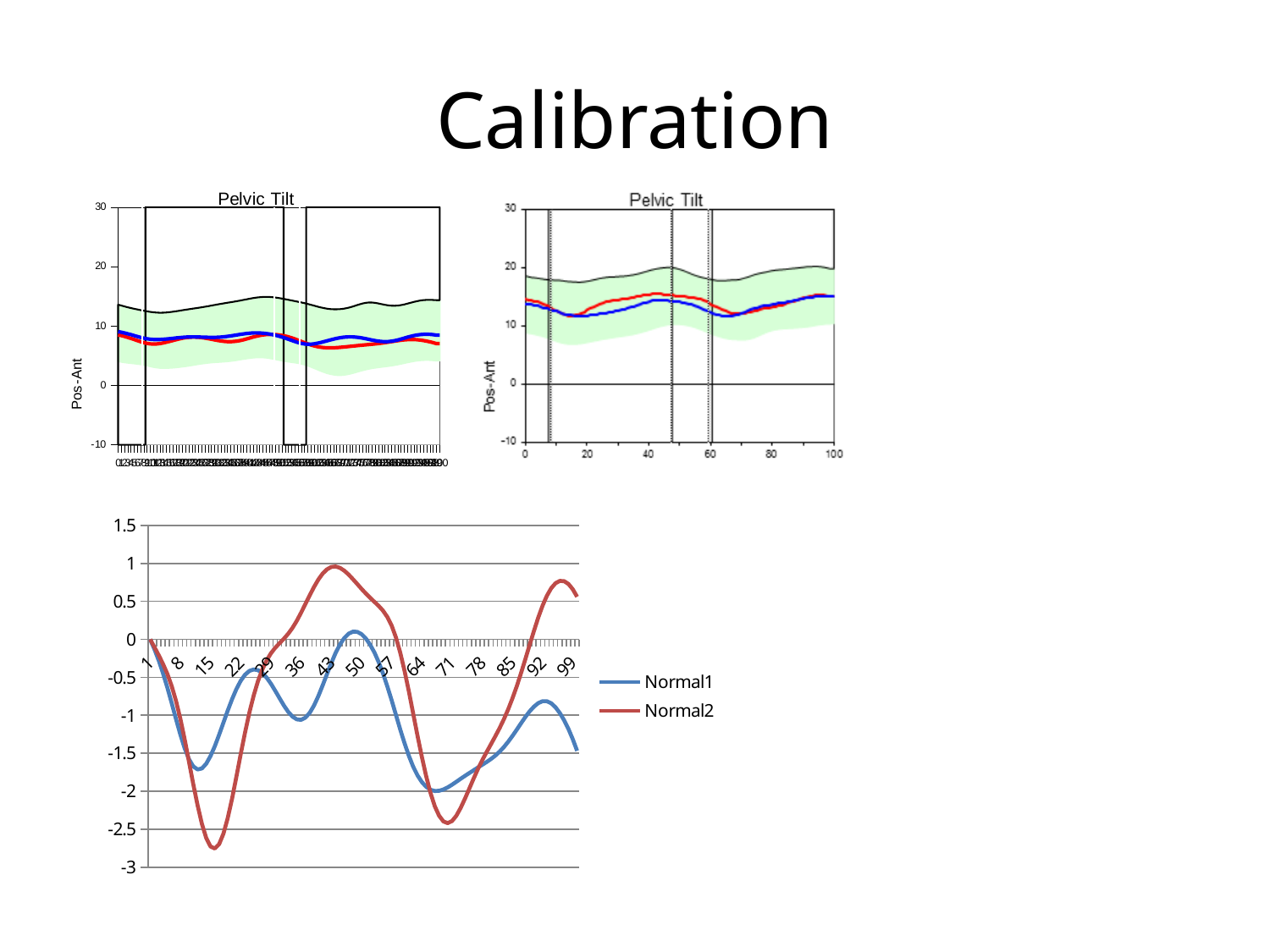
In the bottom chart, which series has the higher value at x = 43, Normal1 or Normal2? Normal2 How many series does the legend of the bottom chart list? 2 In the bottom chart, is the value of Normal1 at x = 15 greater or less than -1? less In the bottom chart, which series has the higher value at x = 15, Normal1 or Normal2? Normal1 In the bottom chart, which series has the higher value at x = 99, Normal1 or Normal2? Normal2 What is the y-axis label on the top-right Pelvic Tilt chart? Pos-Ant What is the title of the two charts at the top of the slide? Pelvic Tilt What kind of chart is the bottom chart with the Normal1 and Normal2 series? Line chart In the bottom chart, is the value of Normal2 at x = 43 greater or less than 0.5? greater In the bottom chart, is the value of Normal1 at x = 64 greater or less than -1.5? less In the bottom chart, does the Normal2 series rise or fall between x = 29 and x = 43? Rise